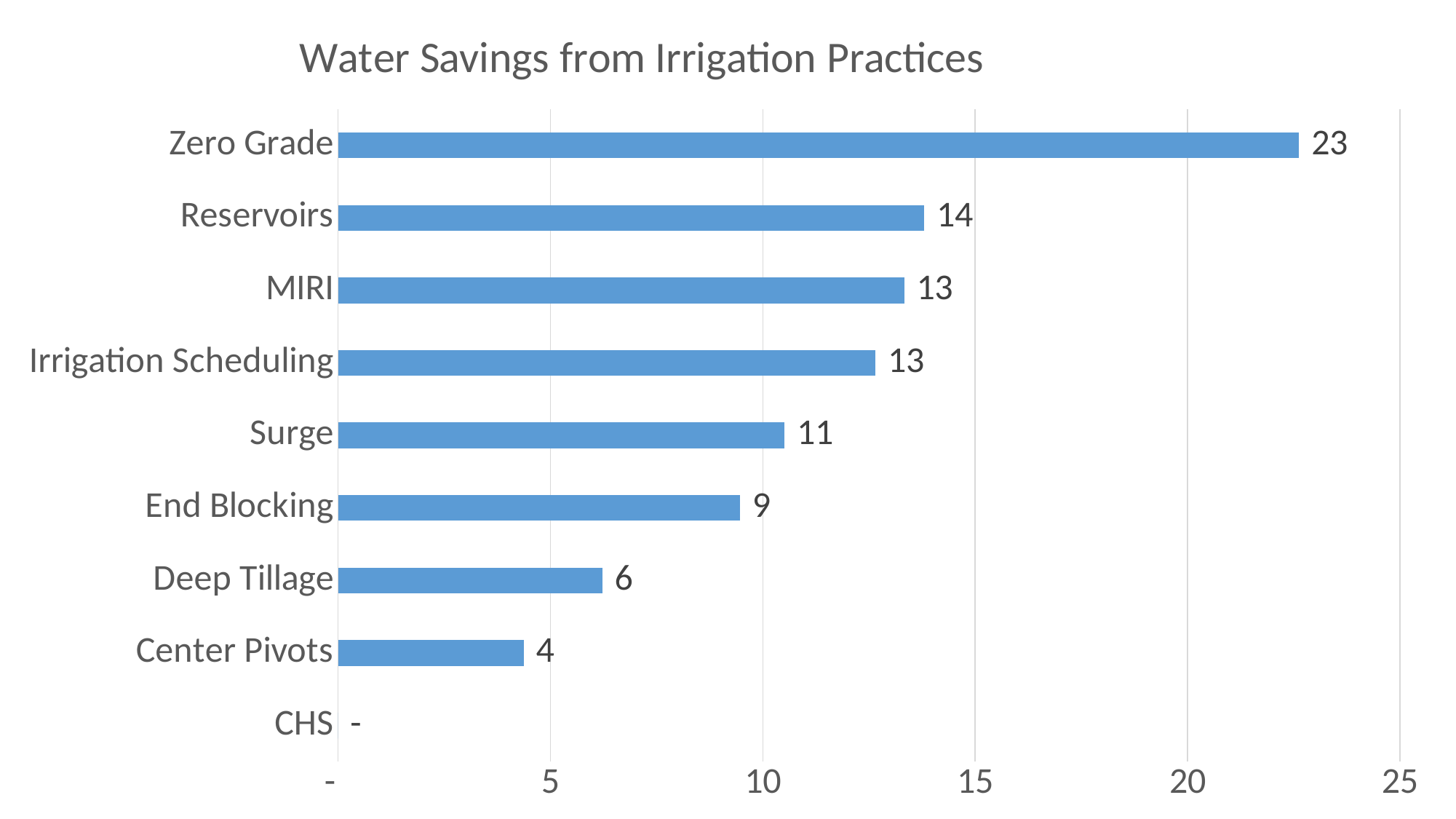
How many categories are shown on the chart? 9 What is the value for Surge? 11 Which is larger, the value for End Blocking or the value for Deep Tillage? End Blocking Which category has the highest value? Zero Grade What is the difference between the values for Zero Grade and Reservoirs? 9 What is the title of the chart? Water Savings from Irrigation Practices What is the value for Zero Grade? 23 Is the value for Surge greater or less than 10? greater What is the value for Reservoirs? 14 What kind of chart is this? Bar chart Which category has the lowest value? CHS What is the value for Center Pivots? 4